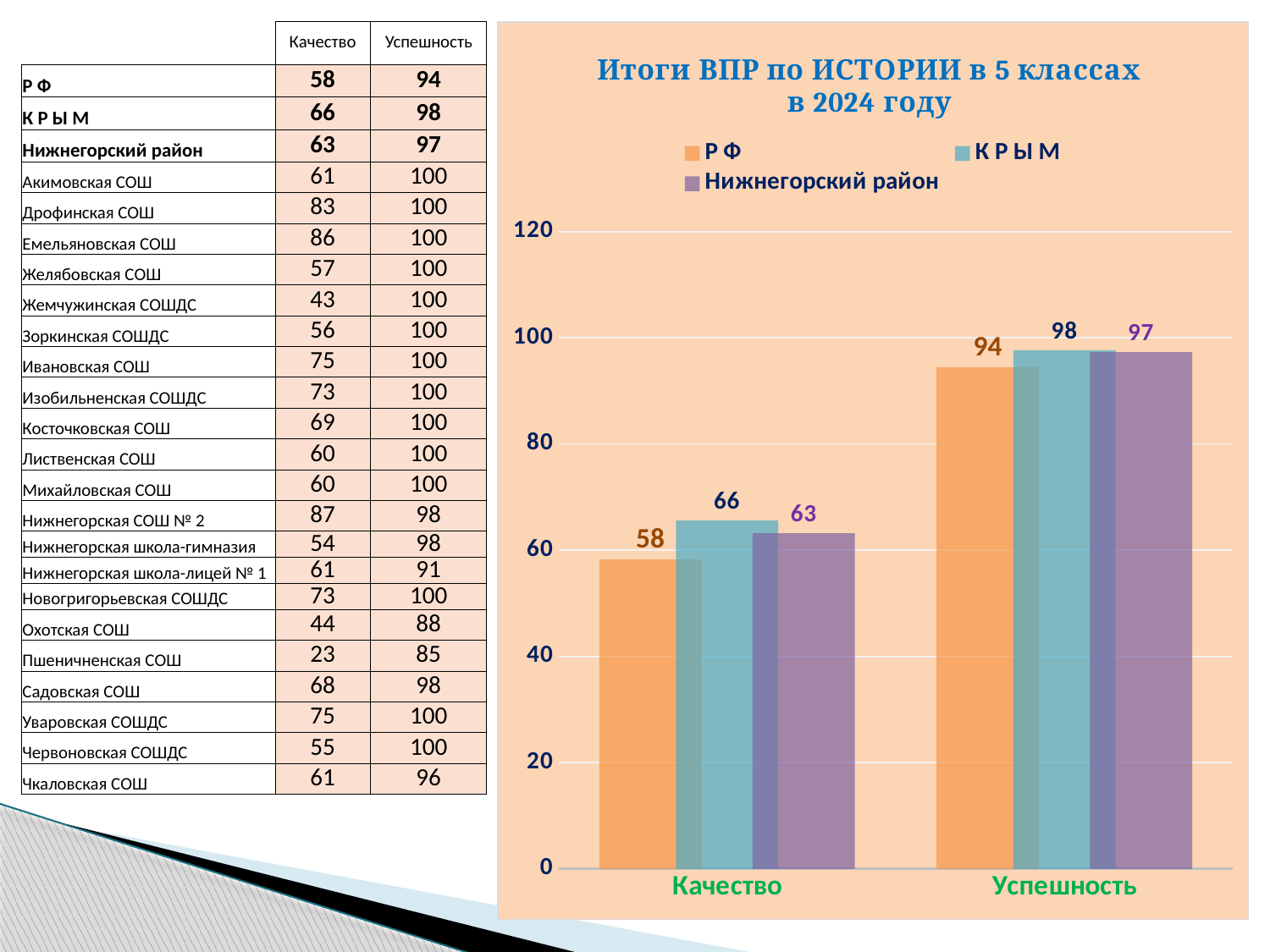
What is the difference between the К Р Ы М and Р Ф values in the Качество category? 8 What is the value for К Р Ы М in the Успешность category? 98 How many series does the legend list? 3 What is the value for Р Ф in the Качество category? 58 What is the title of the chart? Итоги ВПР по ИСТОРИИ в 5 классах в 2024 году What kind of chart is shown on the slide? bar chart Which series has the highest value in the Качество category? К Р Ы М Is the value for Р Ф in the Успешность category greater or less than 100? less What is the value for Нижнегорский район in the Качество category? 63 How many categories are shown on the x axis? 2 Which is larger: the Нижнегорский район value for Успешность or the Р Ф value for Успешность? Нижнегорский район Which series has the lowest value in the Успешность category? Р Ф